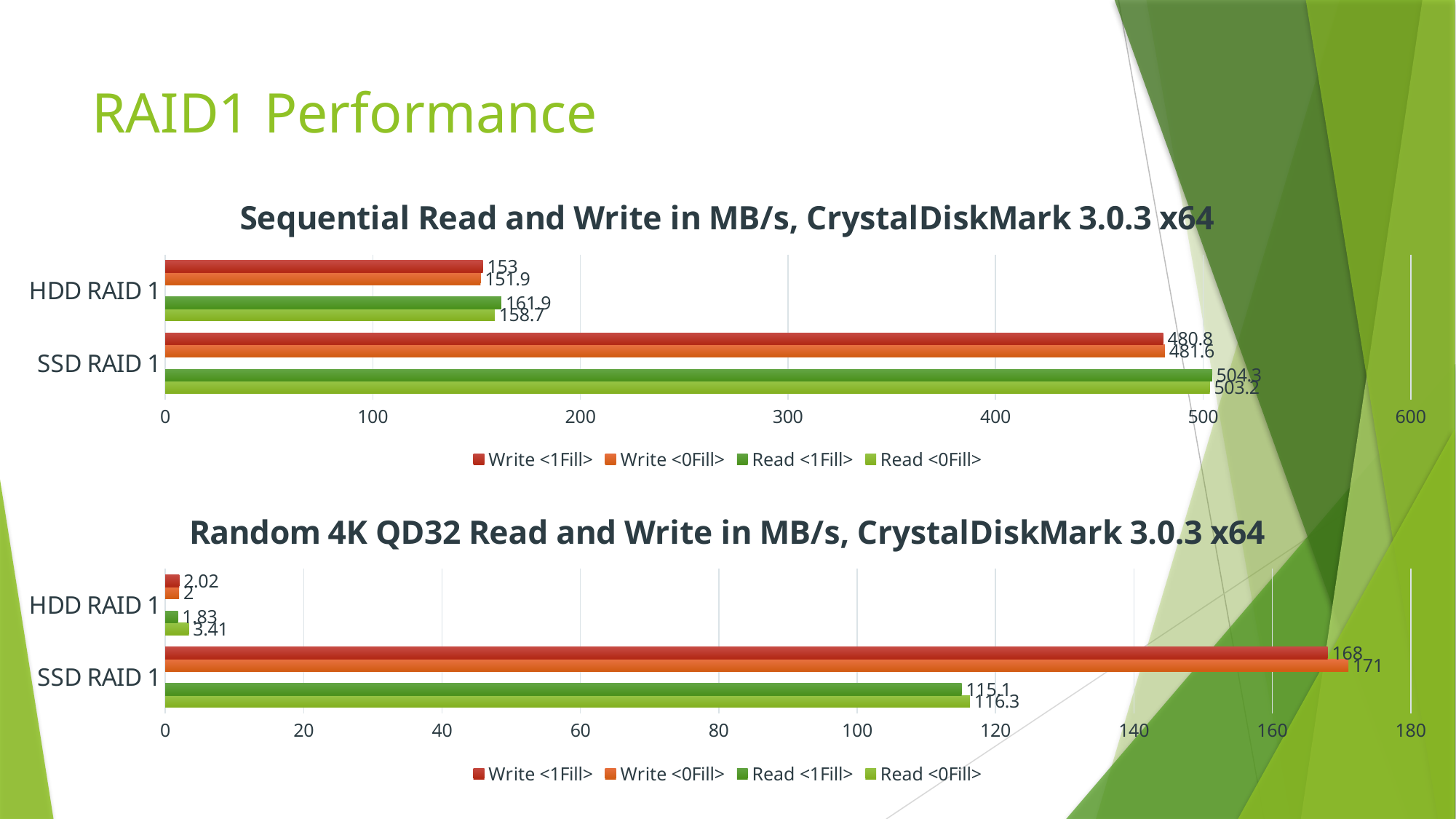
In the Sequential Read and Write chart, what is the Read <1Fill> value for SSD RAID 1? 504.3 How many series does the legend of the Sequential Read and Write chart list? 4 What kind of chart is the Sequential Read and Write chart? Bar chart In the Random 4K QD32 chart, what is the Read <0Fill> value for HDD RAID 1? 3.41 In the Random 4K QD32 chart, what is the Write <0Fill> value for SSD RAID 1? 171 In the Random 4K QD32 chart, what is the difference between the Write <0Fill> and Read <0Fill> values for SSD RAID 1? 54.7 In the Sequential Read and Write chart, what is the Write <1Fill> value for HDD RAID 1? 153 In the Random 4K QD32 chart, which series has the highest value for SSD RAID 1? Write <0Fill> In the Random 4K QD32 chart, which series has the lowest value for HDD RAID 1? Read <1Fill> In the Sequential Read and Write chart, what is the difference between the Read <1Fill> values for SSD RAID 1 and HDD RAID 1? 342.4 In the Random 4K QD32 chart, is the Write <1Fill> value for SSD RAID 1 larger or the Read <1Fill> value for SSD RAID 1? Write <1Fill> How many categories are shown on the y axis of the Random 4K QD32 chart? 2